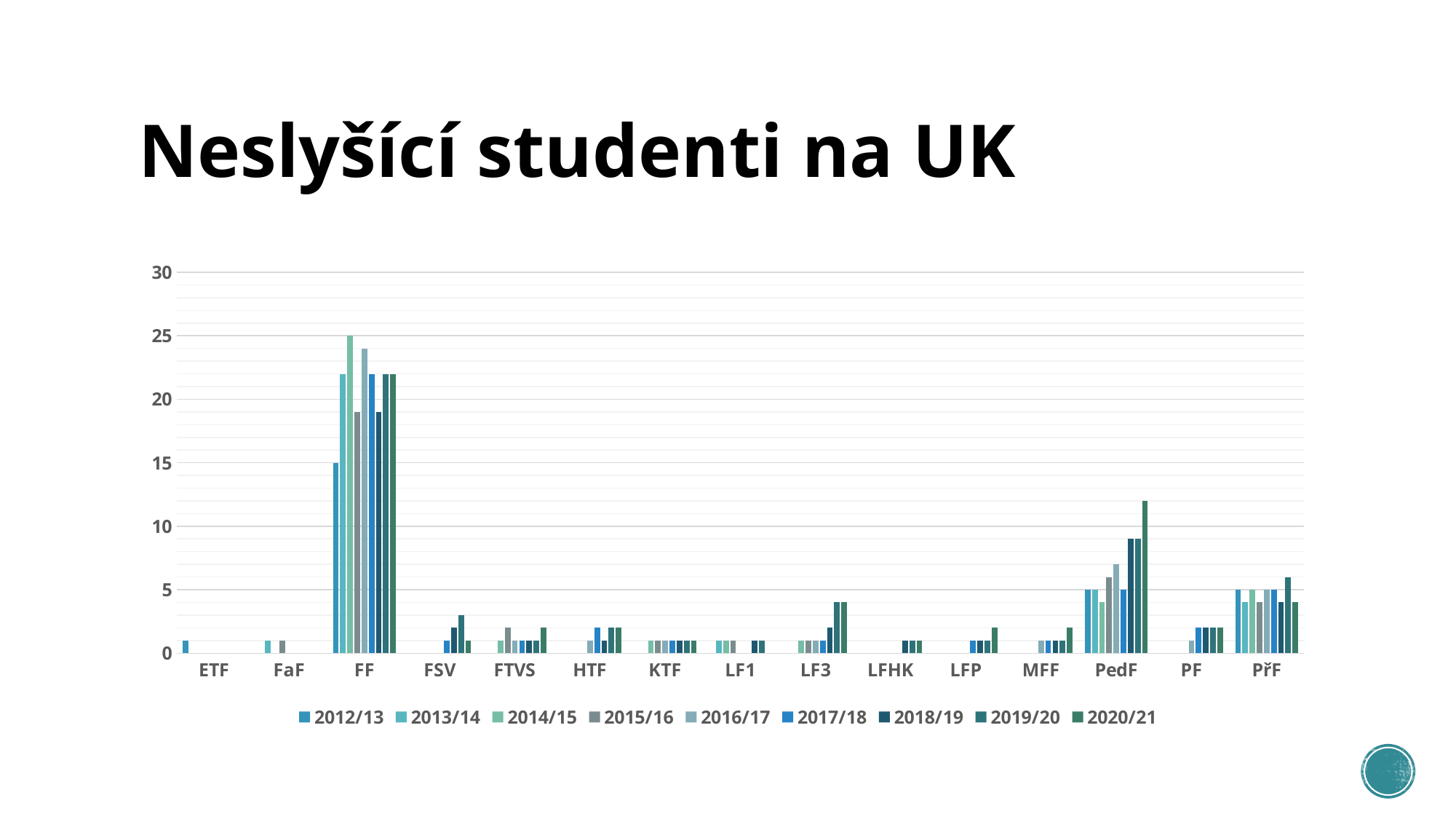
What is the first entry in the legend? 2012/13 What kind of chart is shown on the slide? bar chart Is the value for FF in 2020/21 greater or less than 20? greater Is the value for PedF in 2020/21 greater or less than 10? greater Which is larger in 2020/21: PedF or PřF? PedF How many faculties (categories) are shown on the x axis? 15 What is the value for FF in 2014/15? 25 What is the value for FF in 2012/13? 15 How many academic years does the legend list? 9 Which faculty has the highest number of deaf students across the years? FF What is the value for PedF in 2012/13? 5 What is the title of the chart on the slide? Neslyšící studenti na UK